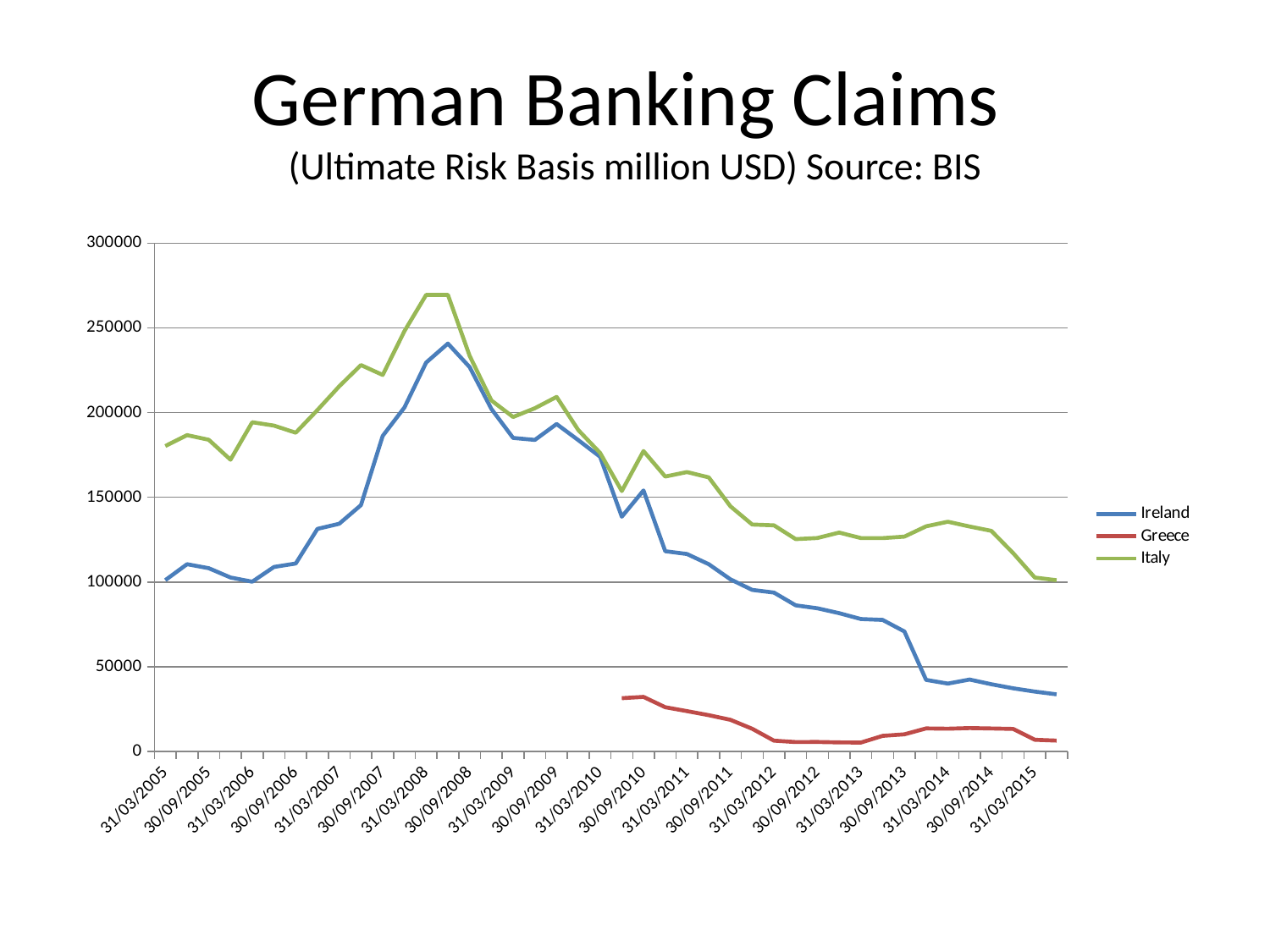
Does the Ireland line rise or fall from 30/09/2008 to 31/03/2015? fall Is the value for Greece at 31/03/2012 greater or less than 50000? less What is the title of the chart? German Banking Claims How many series does the legend list? 3 Which series has the lowest value at 31/03/2015? Greece Is the value for Ireland at 31/03/2015 greater or less than 50000? less Is the value for Italy at 31/03/2008 greater or less than 250000? greater What kind of chart is shown on the slide? line chart Which series has the highest value at 31/03/2008? Italy Which colour is used for the Greece line? red